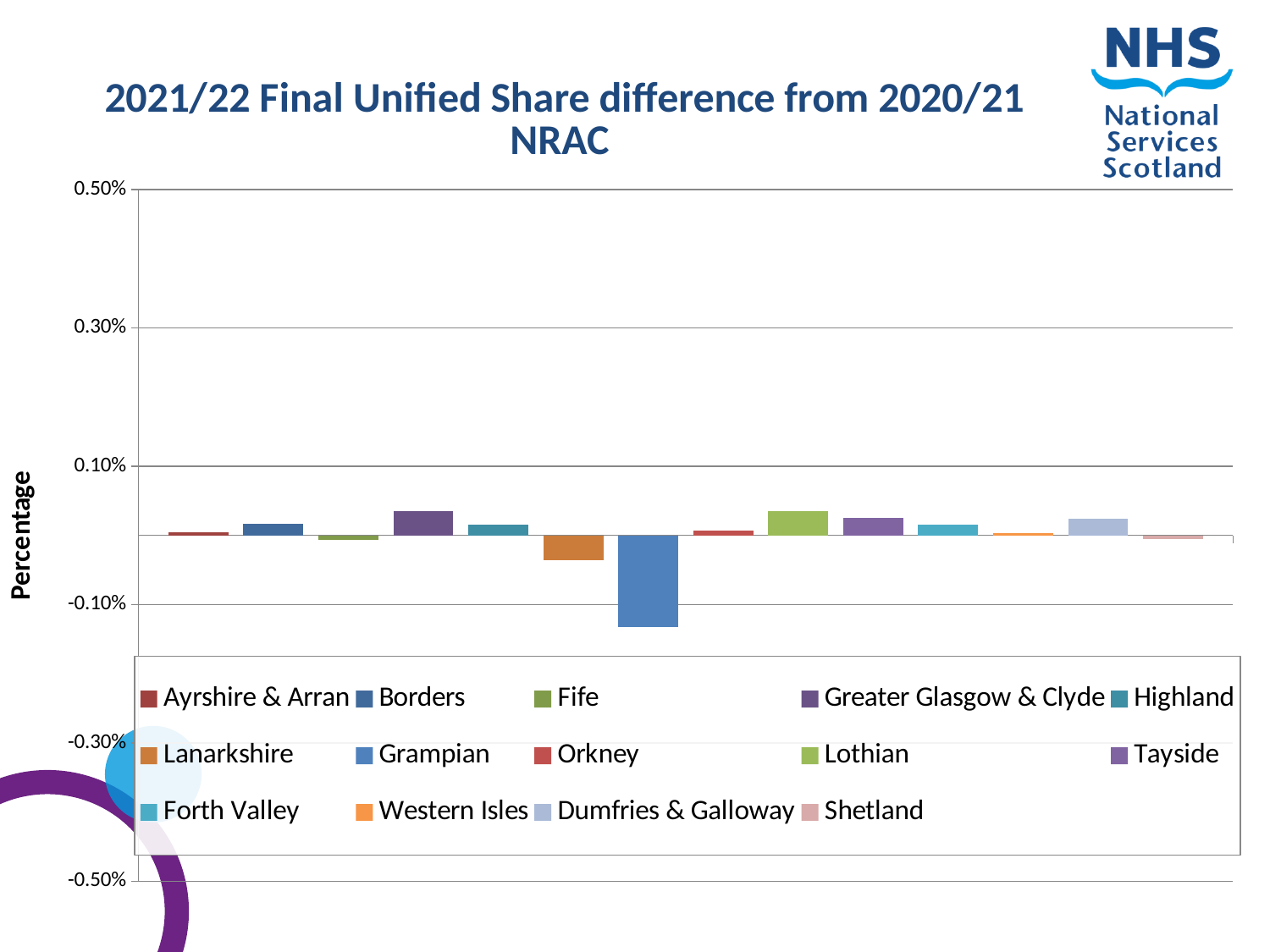
Which has the larger value, Borders or Fife? Borders How many entries does the chart's legend list? 14 What kind of chart is shown on the slide? bar chart Which has the larger value, Lothian or Shetland? Lothian What is the title of the chart? 2021/22 Final Unified Share difference from 2020/21 NRAC Which health board has the lowest value in the chart? Grampian How many bars are plotted in the chart? 14 Which has the larger value, Grampian or Lanarkshire? Lanarkshire Is the value for Lanarkshire greater or less than -0.10%? greater Is the value for Greater Glasgow & Clyde greater or less than 0.10%? less Is the value for Grampian greater or less than -0.10%? less What is the label on the vertical axis of the chart? Percentage